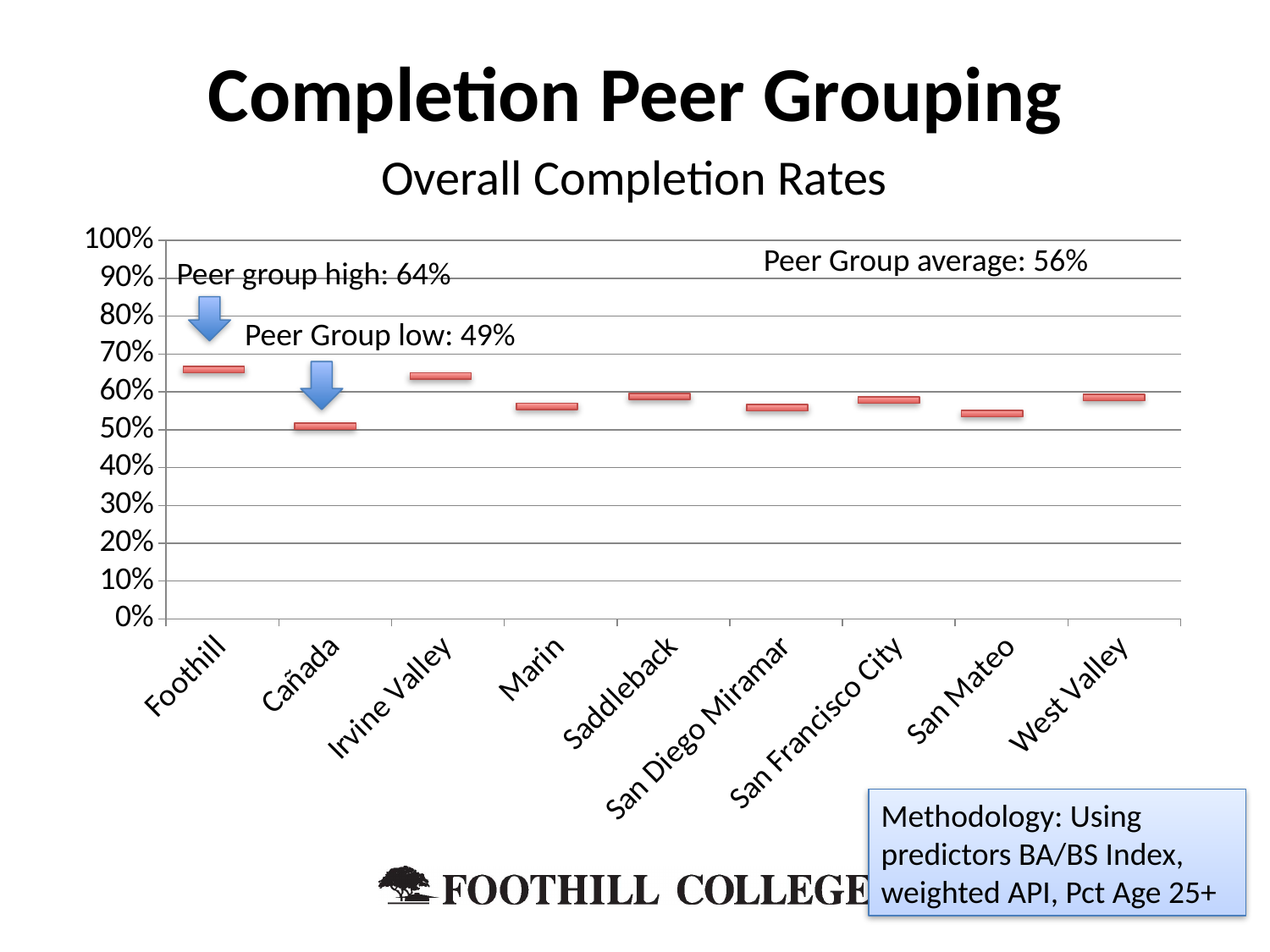
Which has a higher completion rate, Foothill or Marin? Foothill Is the value for San Diego Miramar greater or less than 70%? less How many colleges are shown on the x axis of the chart? 9 Is the value for Marin greater or less than 60%? less Which college has the lowest overall completion rate? Cañada Is the value for Irvine Valley greater or less than 60%? greater Which college has the highest overall completion rate? Foothill What peer group average does the chart annotation state? 56% Which has a higher completion rate, Cañada or San Mateo? San Mateo